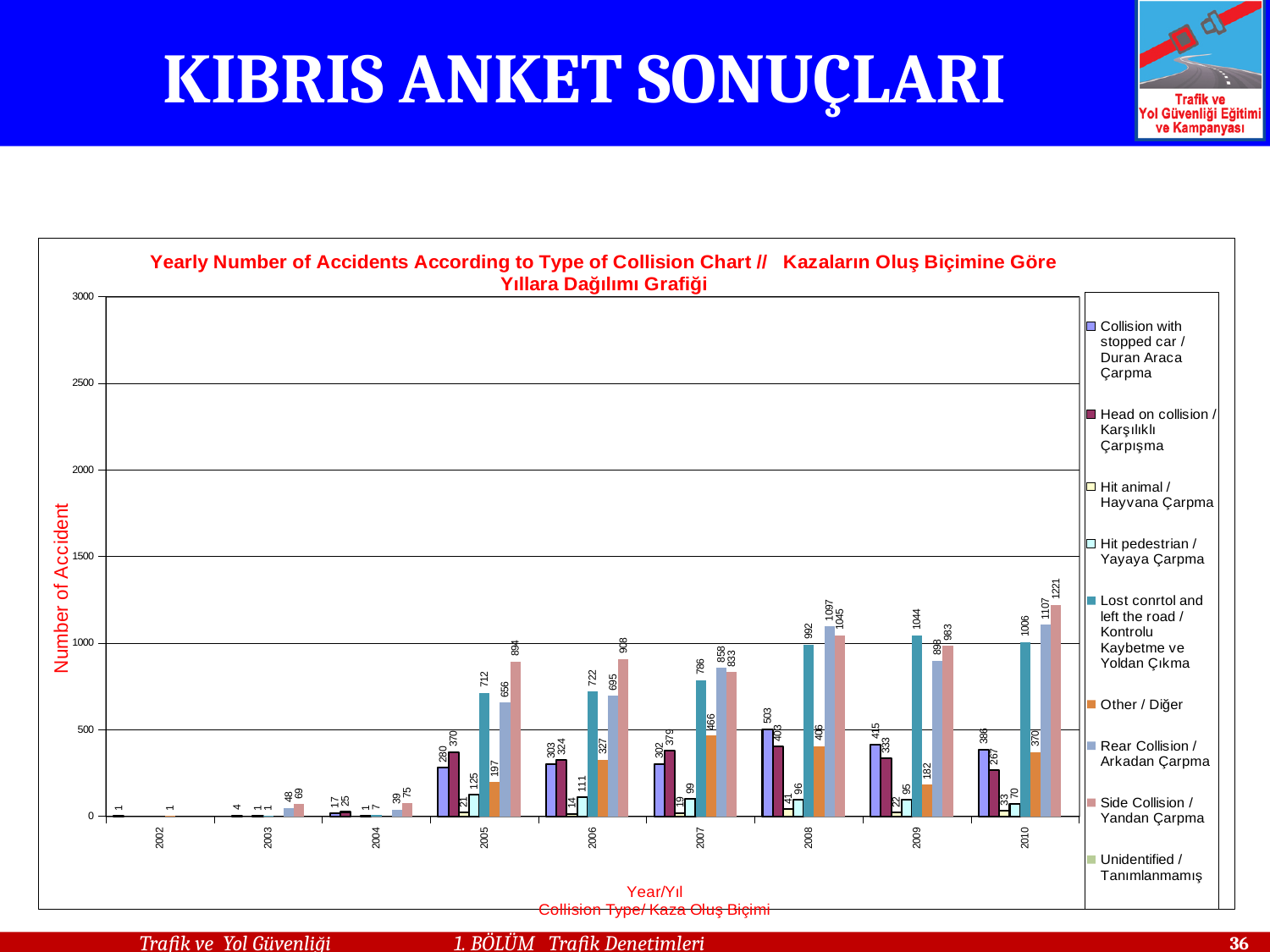
What is the number of accidents for 'Lost conrtol and left the road' in 2008? 992 What is the title of the y axis? Number of Accident Does the 'Lost conrtol and left the road' value rise or fall from 2005 to 2009? Rise In 2008, which is larger: 'Rear Collision' or 'Side Collision'? Rear Collision What is the number of 'Side Collision' accidents in 2010? 1221 What kind of chart is shown on the slide? Bar chart What is the difference between the 'Rear Collision' values for 2010 and 2009? 209 How many series does the legend list? 9 In which year is the 'Side Collision' value highest? 2010 How many years are shown on the x axis? 9 What is the value for 'Rear Collision' in 2007? 858 What is the value for 'Collision with stopped car' in 2008? 503